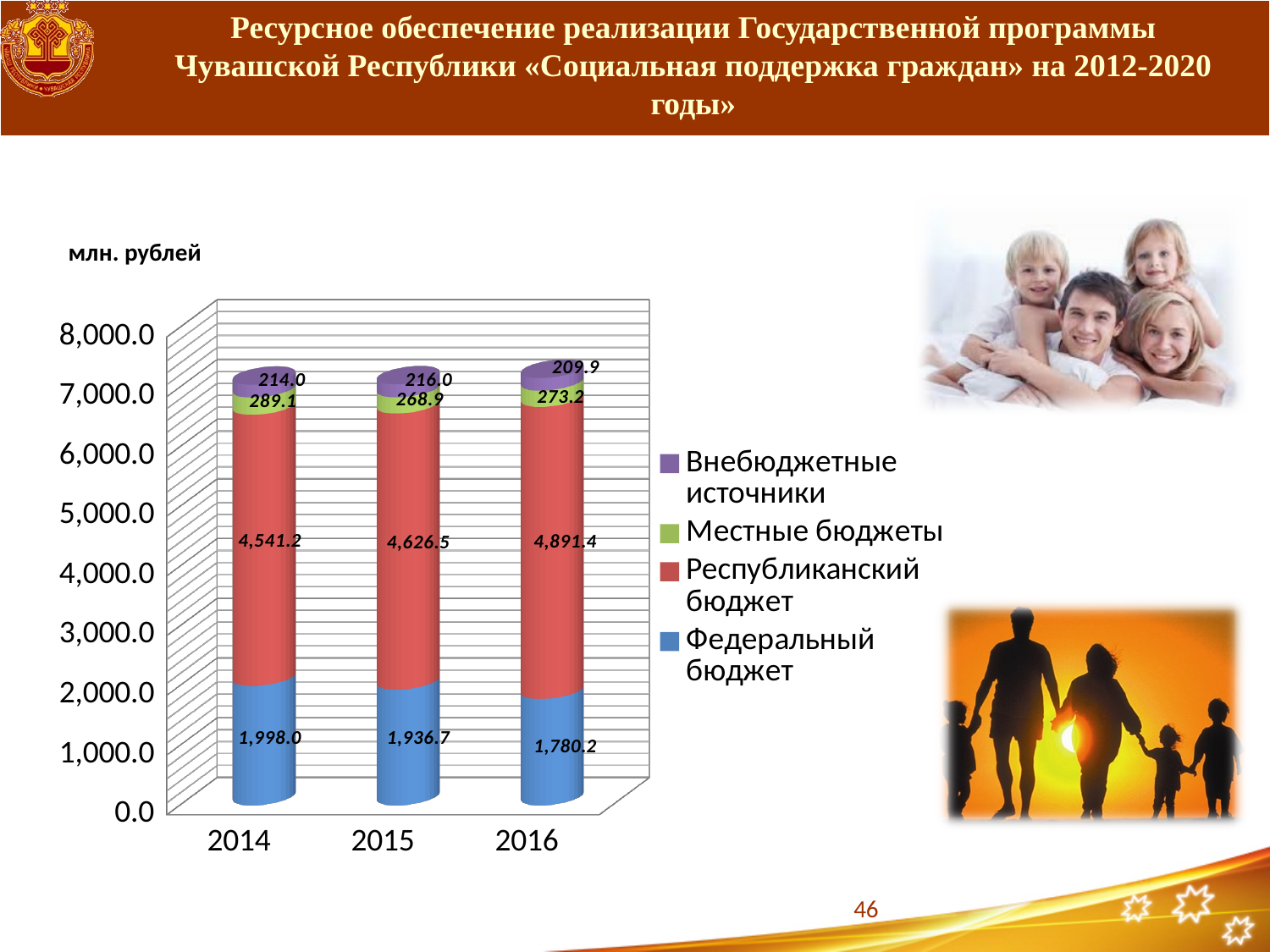
By how much does Республиканский бюджет in 2016 exceed Республиканский бюджет in 2014? 350.2 How many years (categories) are shown on the x axis of the chart? 3 How many series does the chart legend list? 4 In which year is the Республиканский бюджет value the highest? 2016 What is the total of the stacked bar for 2014? 7,042.3 In which year is the Федеральный бюджет value the lowest? 2016 What is the value of Местные бюджеты for 2015? 268.9 What is the value of Республиканский бюджет for 2016? 4,891.4 What is the value of Федеральный бюджет for 2014? 1,998.0 What type of chart is shown on the slide? stacked bar chart What is the value of Внебюджетные источники for 2016? 209.9 What unit of measurement is indicated above the chart? млн. рублей